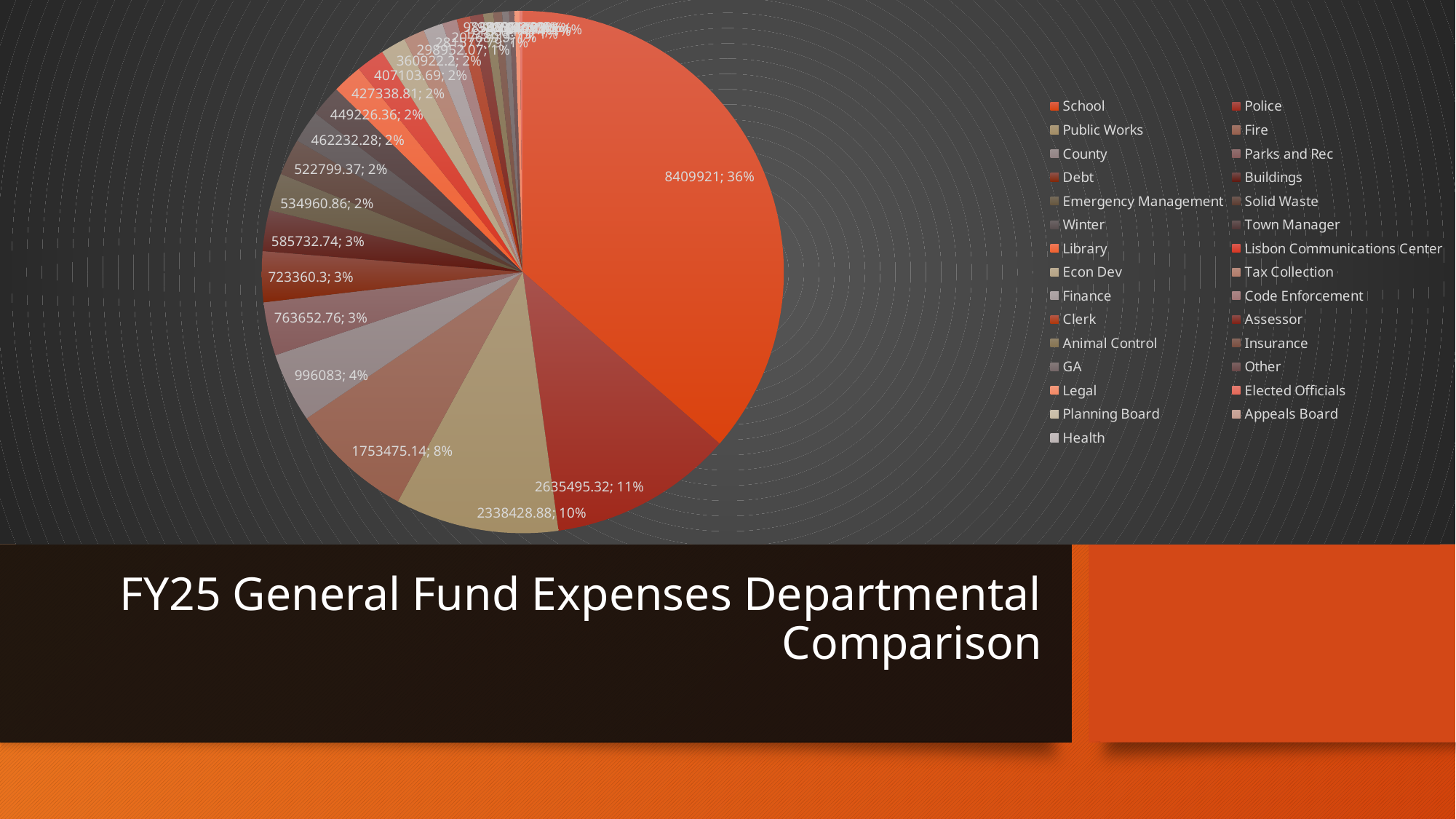
What is the difference between the School slice (8409921) and the 11% slice (2635495.32)? 5774425.68 What is the value of the slice labelled 8%? 1753475.14 What is the title of the slide? FY25 General Fund Expenses Departmental Comparison What kind of chart is shown on the slide? pie chart What is the value of the slice labelled 10%? 2338428.88 What is the value of the slice labelled 4%? 996083 How many departments are listed in the legend? 29 Which department has the largest slice of the pie? School What is the value shown for the School slice? 8409921 What is the value of the slice labelled 11%? 2635495.32 What share of the pie does the School slice represent? 36% What is the difference between the 11% slice (2635495.32) and the 10% slice (2338428.88)? 297066.44